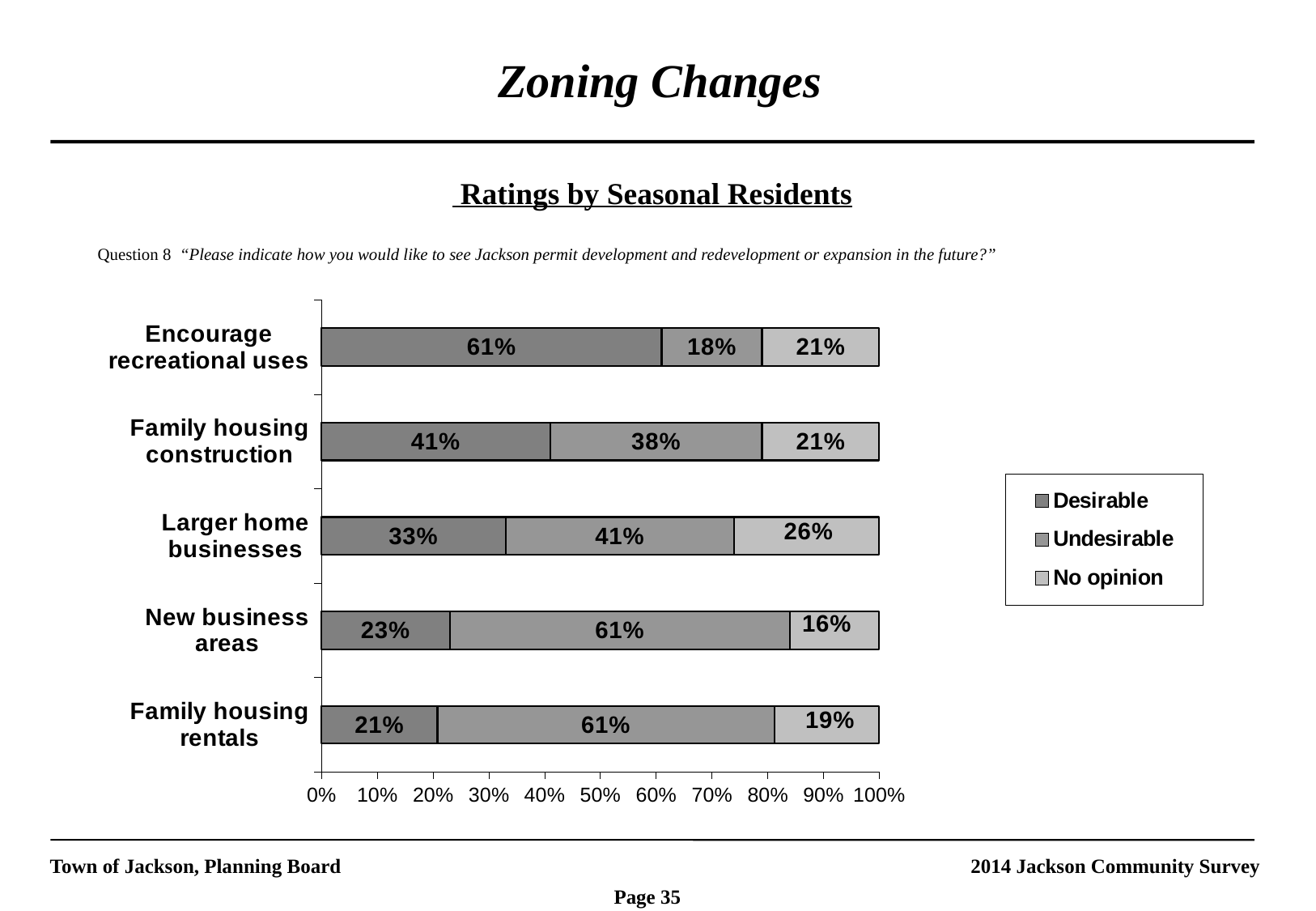
What is the Undesirable value for "New business areas"? 61% What percentage of seasonal residents rated "Encourage recreational uses" as Desirable? 61% Which category has the highest Desirable percentage? Encourage recreational uses How many series does the legend list? 3 Which series is listed last in the legend? No opinion Which is larger for "Larger home businesses": the Desirable value or the Undesirable value? Undesirable What kind of chart is shown on the slide? Stacked bar chart How many categories are shown on the chart? 5 What is the No opinion value for "Larger home businesses"? 26% Which category has the lowest Desirable percentage? Family housing rentals What is the total of the stacked bar for "New business areas"? 100% What is the difference between the Desirable and Undesirable values for "Family housing construction"? 3%